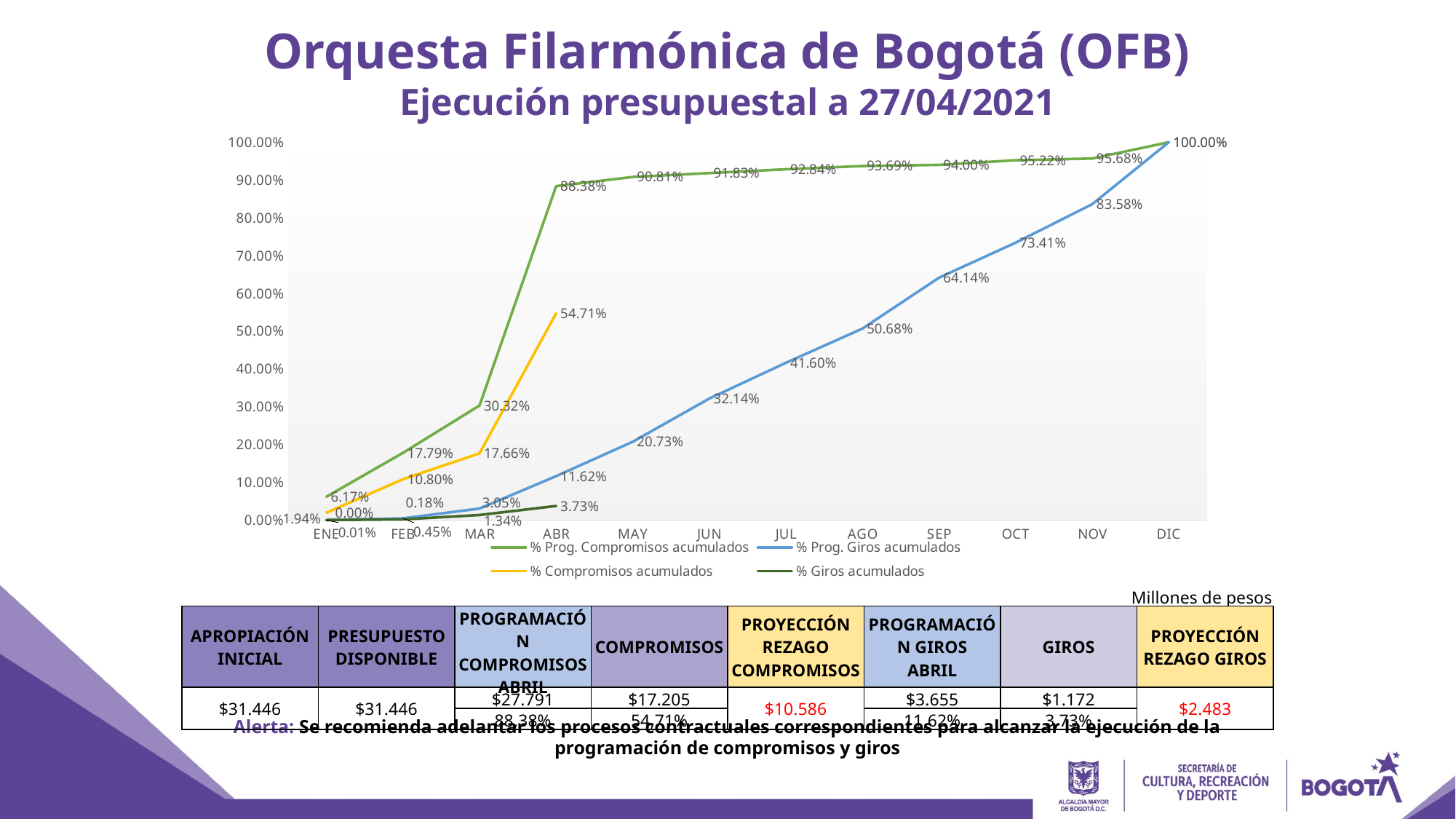
How many months are shown along the x axis of the chart? 12 What is the value of % Prog. Giros acumulados in SEP? 64.14% What is the difference between % Prog. Compromisos acumulados and % Compromisos acumulados in ABR? 33.67% What kind of chart is shown on the slide? line chart What is the value of % Compromisos acumulados in ABR? 54.71% What is the value of % Prog. Compromisos acumulados in MAY? 90.81% How many series does the chart legend list? 4 In ABR, which is larger: % Prog. Giros acumulados or % Giros acumulados? % Prog. Giros acumulados What is the value of % Prog. Compromisos acumulados in ABR? 88.38% Does the % Prog. Giros acumulados series rise or fall from ENE to DIC? rise In which month does % Prog. Giros acumulados reach its highest value? DIC What is the value of % Giros acumulados in ABR? 3.73%